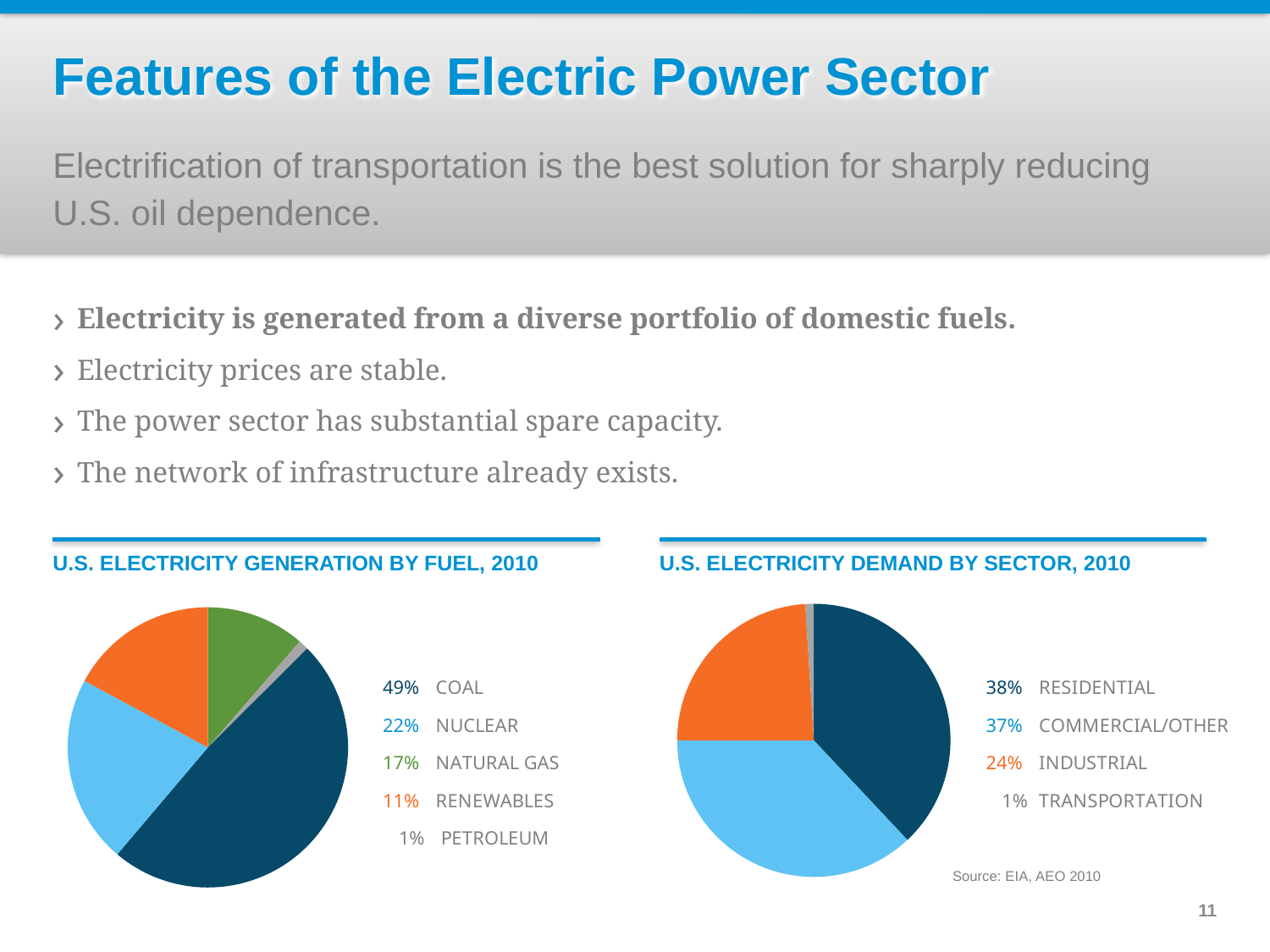
In the 'U.S. Electricity Demand by Sector, 2010' chart, how many sectors are shown? 4 What kind of chart is 'U.S. Electricity Generation by Fuel, 2010'? Pie chart In the 'U.S. Electricity Generation by Fuel, 2010' chart, what is the difference between the coal share and the nuclear share? 27% In the 'U.S. Electricity Demand by Sector, 2010' chart, which sector has the smallest share? Transportation In the 'U.S. Electricity Generation by Fuel, 2010' chart, what share of generation comes from natural gas? 17% In the 'U.S. Electricity Demand by Sector, 2010' chart, what share of demand comes from the industrial sector? 24% In the 'U.S. Electricity Demand by Sector, 2010' chart, what share of demand comes from transportation? 1% In the 'U.S. Electricity Generation by Fuel, 2010' chart, how many fuel categories are shown? 5 In the 'U.S. Electricity Demand by Sector, 2010' chart, what is the difference between the residential share and the industrial share? 14% In the 'U.S. Electricity Generation by Fuel, 2010' chart, which fuel has the largest share? Coal In the 'U.S. Electricity Generation by Fuel, 2010' chart, which fuel has the smallest share? Petroleum In the 'U.S. Electricity Generation by Fuel, 2010' chart, what share of generation comes from coal? 49%